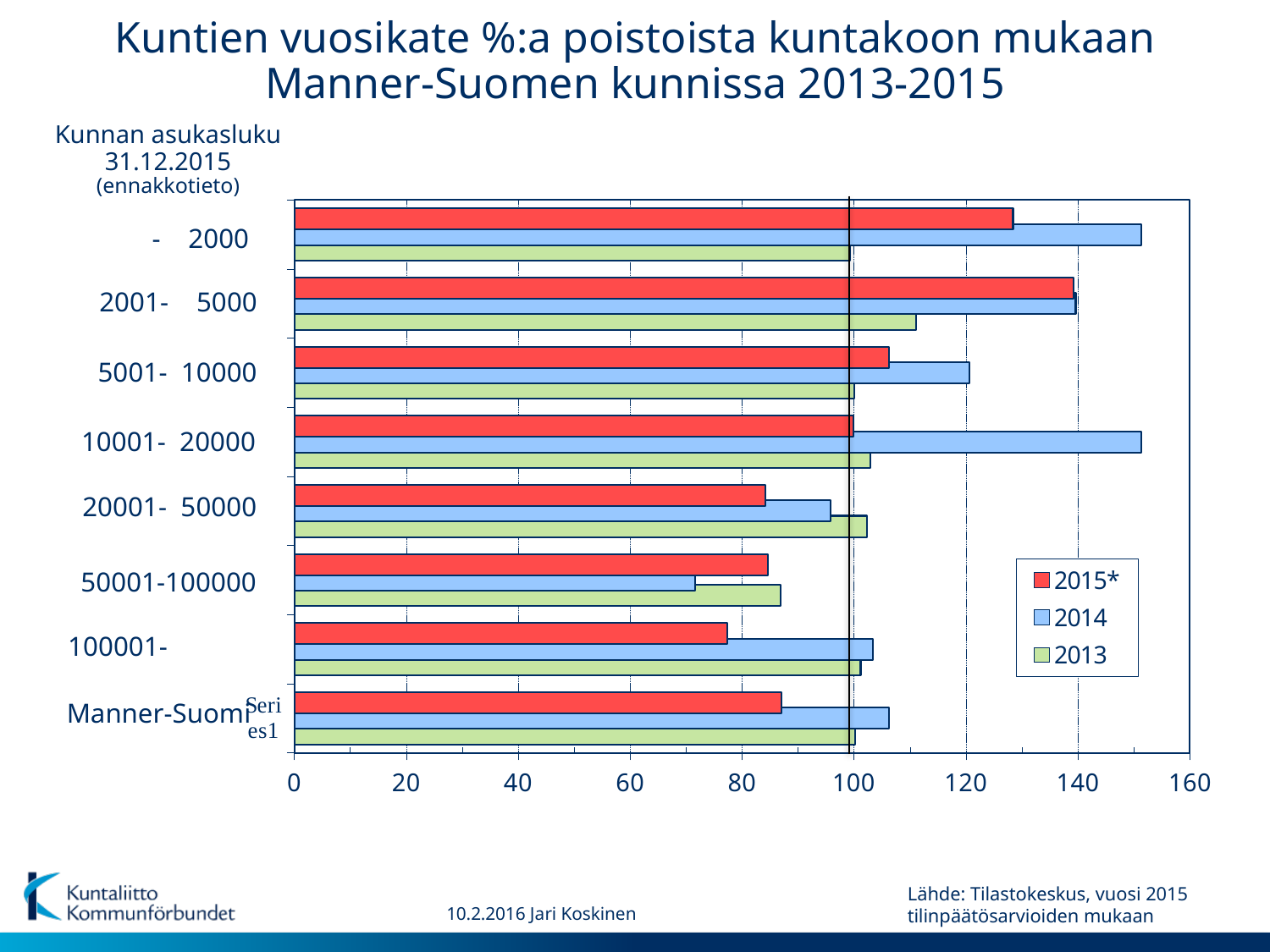
Is the 2015* value for the '100001-' category greater or less than 80? less What kind of chart is shown on the slide? bar chart Is the 2015* value for the '- 2000' category greater or less than 120? greater Which category has the lowest 2014 value? 50001-100000 How many categories are shown on the vertical axis of the chart? 8 Which category has the highest 2015* value? 2001- 5000 Is the 2014 value for the '10001- 20000' category greater or less than 140? greater How many series does the legend list? 3 Which series is shown in green in the legend? 2013 For the '5001- 10000' category, which is larger: the 2014 value or the 2015* value? 2014